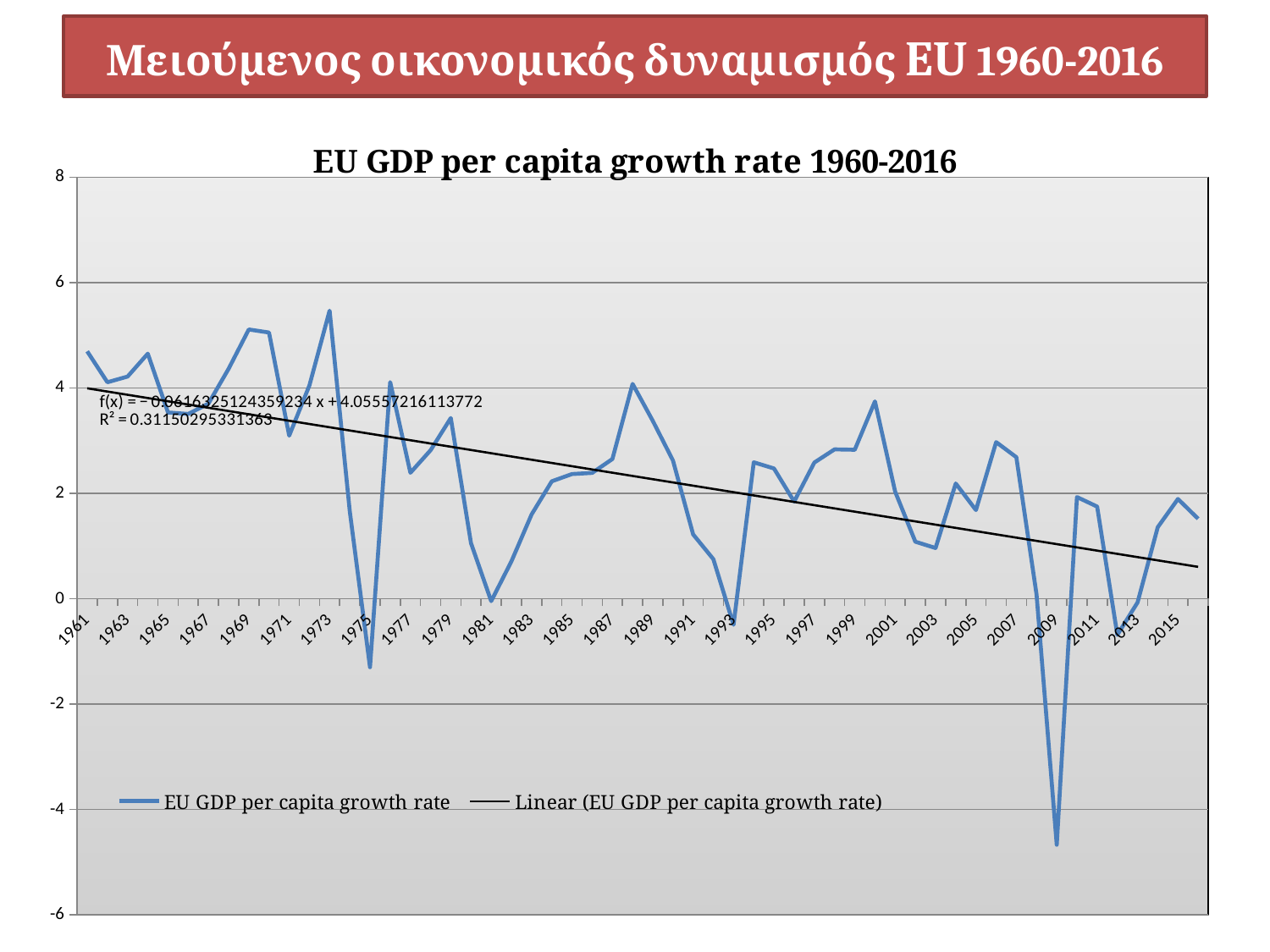
What R² value is printed on the chart? 0.31150295331363 In which year does the EU GDP per capita growth rate reach its highest value? 1973 Which year has the larger EU GDP per capita growth rate, 1969 or 1981? 1969 Does the linear trend line rise or fall from 1961 to 2016? fall Is the EU GDP per capita growth rate for 2009 greater or less than -4? less What is the title of the chart? EU GDP per capita growth rate 1960-2016 Is the EU GDP per capita growth rate for 1988 greater or less than 2? greater How many series does the legend list? 2 In which year does the EU GDP per capita growth rate reach its lowest value? 2009 Is the EU GDP per capita growth rate for 1973 greater or less than 4? greater What kind of chart is shown on the slide? line chart